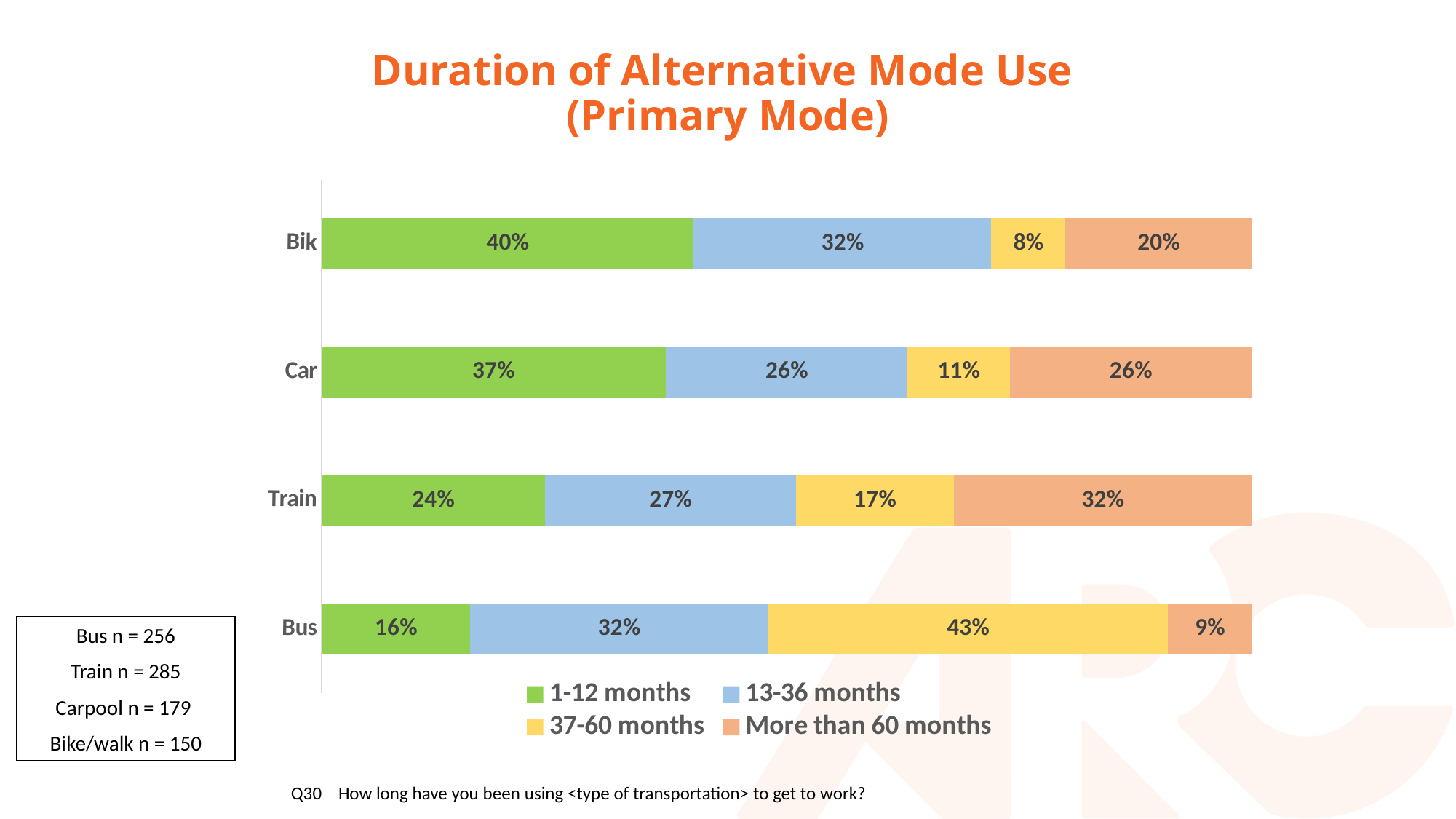
What percentage of Bus users have used it for 37-60 months? 43% Which category has the highest value for 1-12 months? Bik Which category has the lowest value for 'More than 60 months'? Bus What is the difference between the 37-60 months values for Bus and Bik? 35% What kind of chart is shown on the slide? Stacked bar chart What is the value for Train in the 'More than 60 months' series? 32% How many series does the legend list? 4 Which is larger: the 1-12 months value for Train or for Bus? Train How many categories are shown on the y axis? 4 What percentage of Car users have used it for 1-12 months? 37% What is the value for Bik in the 13-36 months series? 32% What is the title of the chart? Duration of Alternative Mode Use (Primary Mode)